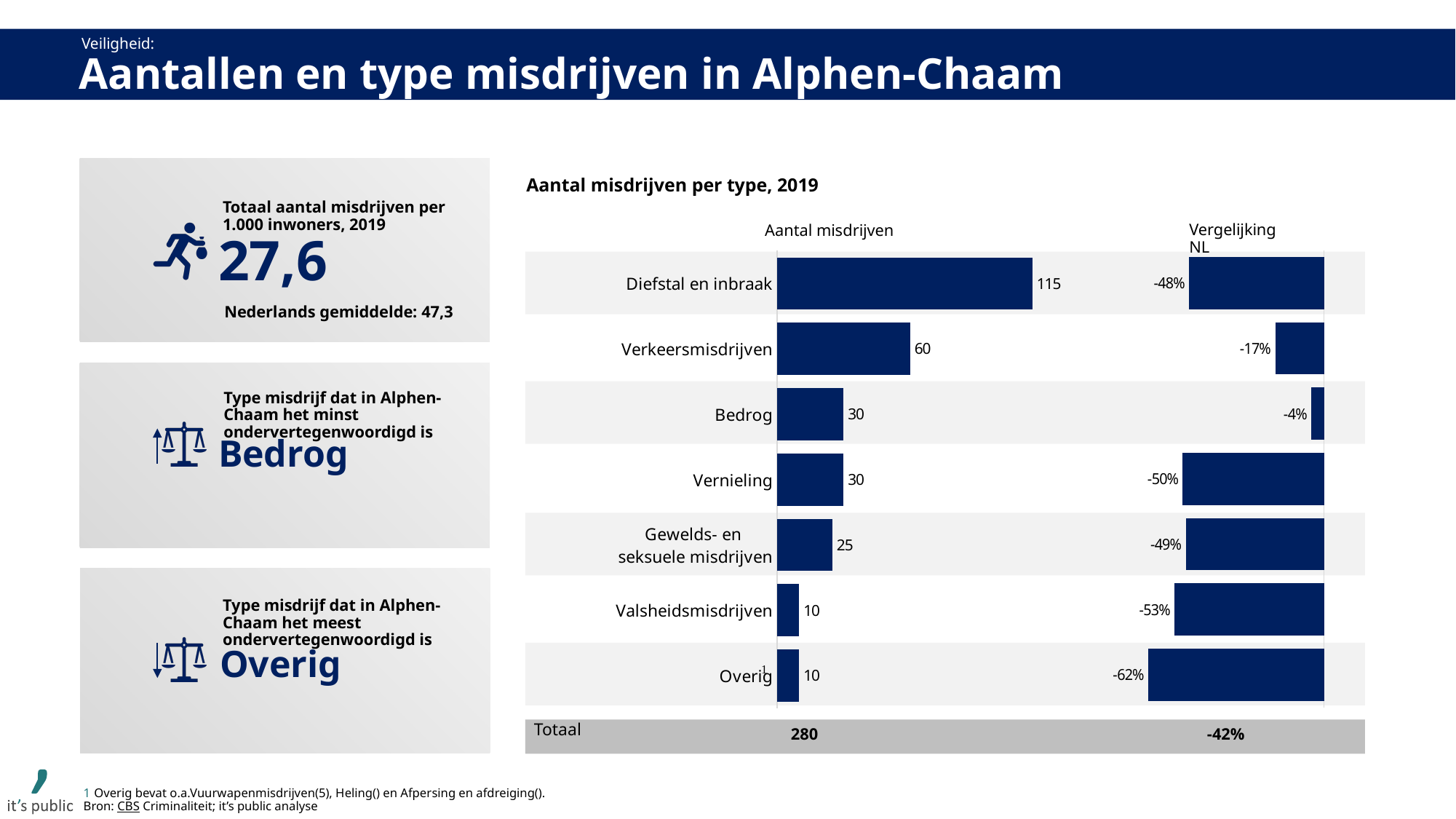
In the chart 'Aantal misdrijven per type, 2019', what is the 'Aantal misdrijven' value for Verkeersmisdrijven? 60 What type of chart is 'Aantal misdrijven per type, 2019'? Bar chart In the chart 'Aantal misdrijven per type, 2019', what is the 'Vergelijking NL' value for Bedrog? -4% In the chart 'Aantal misdrijven per type, 2019', what is the 'Vergelijking NL' value for Overig? -62% In the chart 'Aantal misdrijven per type, 2019', what is the 'Totaal' value for 'Vergelijking NL'? -42% In the chart 'Aantal misdrijven per type, 2019', which has a higher 'Aantal misdrijven': Verkeersmisdrijven or Gewelds- en seksuele misdrijven? Verkeersmisdrijven In the chart 'Aantal misdrijven per type, 2019', what is the 'Aantal misdrijven' value for Diefstal en inbraak? 115 In the chart 'Aantal misdrijven per type, 2019', what is the difference in 'Aantal misdrijven' between Diefstal en inbraak and Verkeersmisdrijven? 55 In the chart 'Aantal misdrijven per type, 2019', how many crime types are listed? 7 In the chart 'Aantal misdrijven per type, 2019', which crime type has the highest 'Aantal misdrijven'? Diefstal en inbraak In the chart 'Aantal misdrijven per type, 2019', which crime type has the 'Vergelijking NL' value closest to zero? Bedrog In the chart 'Aantal misdrijven per type, 2019', what is the 'Totaal' value for 'Aantal misdrijven'? 280